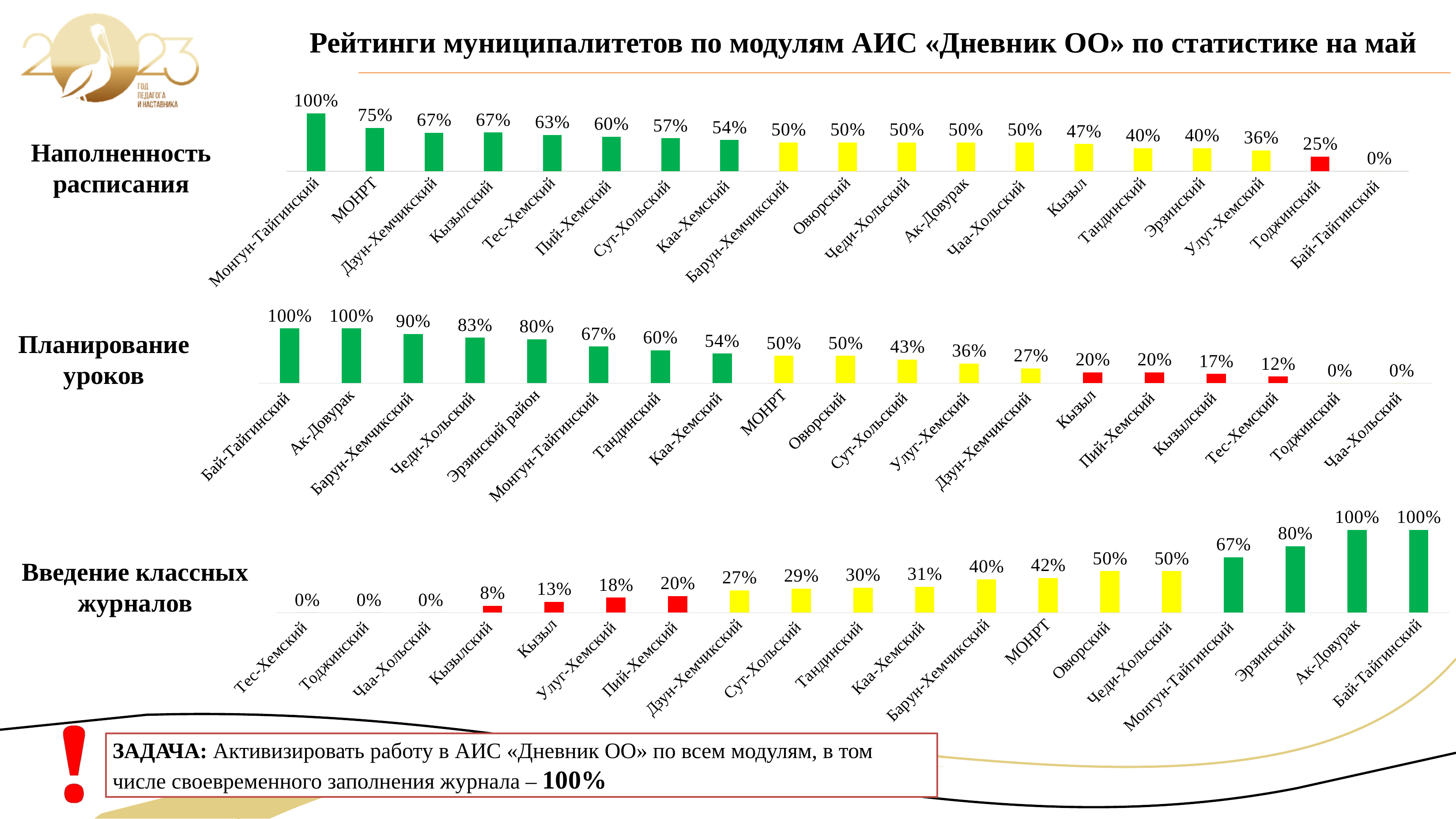
In the "Введение классных журналов" chart, what is the difference between Овюрский and Кызыл? 37% What type of chart is the "Планирование уроков" chart? bar chart How many municipalities are shown in the "Введение классных журналов" chart? 19 In the "Введение классных журналов" chart, do the values rise or fall from left to right? rise In the "Введение классных журналов" chart, what is the value for Эрзинский? 80% In the "Планирование уроков" chart, which is larger: Барун-Хемчикский or Тандинский? Барун-Хемчикский In the "Наполненность расписания" chart, what colour is the bar for Тоджинский? red In the "Планирование уроков" chart, what is the value for Тес-Хемский? 12% In the "Планирование уроков" chart, what is the value for Чеди-Хольский? 83% In the "Наполненность расписания" chart, what is the value for МОНРТ? 75% In the "Наполненность расписания" chart, what is the difference between Тес-Хемский and Тоджинский? 38% In the "Наполненность расписания" chart, which municipality has the highest value? Монгун-Тайгинский